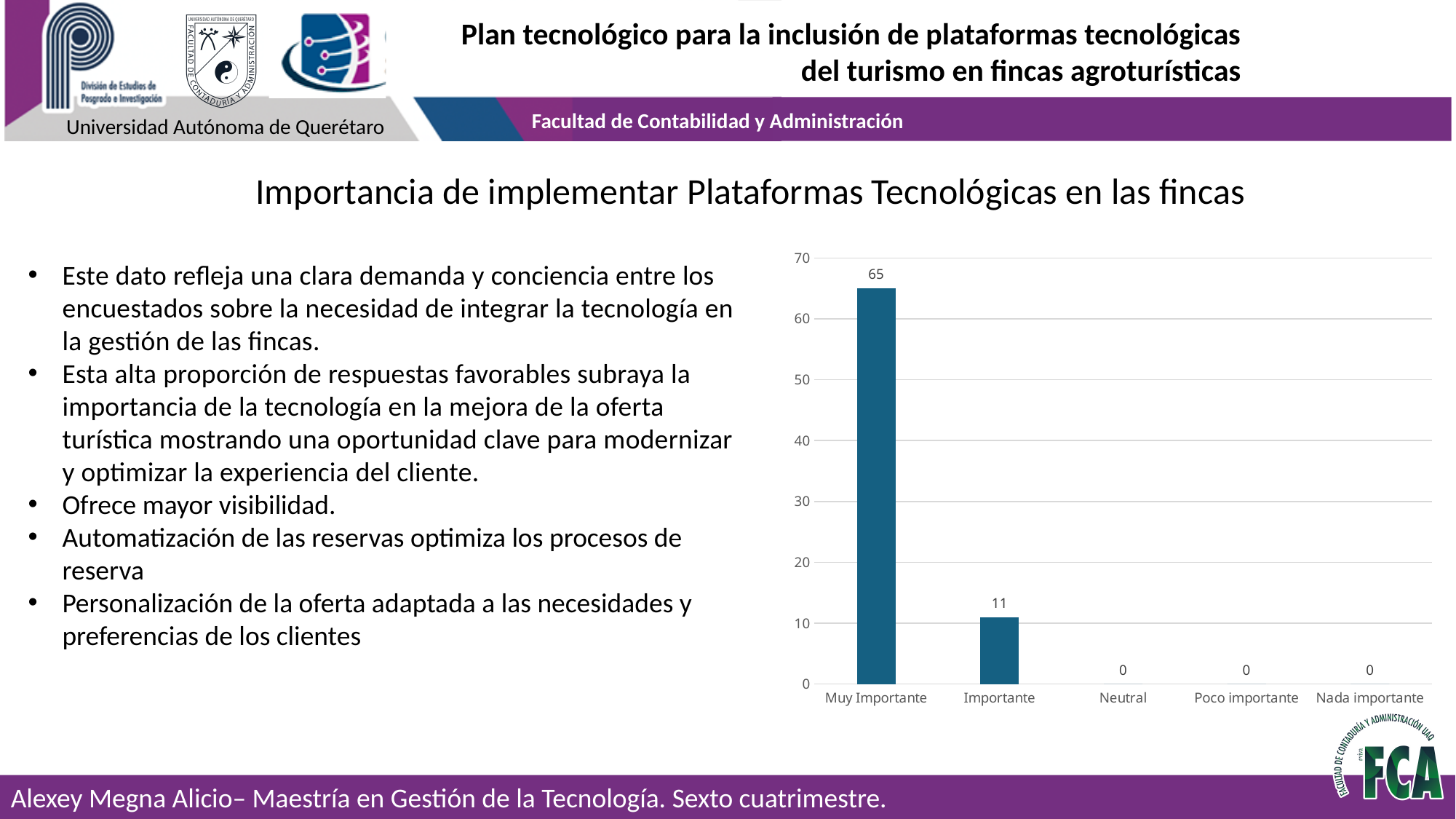
What is the value for Poco importante? 0 What is the value for Muy Importante? 65 Which category has the highest value? Muy Importante What is the value for Importante? 11 What is the value for Neutral? 0 Which is larger, the value for Importante or the value for Neutral? Importante Do the values rise or fall from left to right along the x axis? fall What is the difference between the values for Muy Importante and Importante? 54 How many categories are shown on the x axis? 5 What kind of chart is shown on the slide? bar chart Is the value for Muy Importante greater or less than 60? greater How many categories have a value of 0? 3